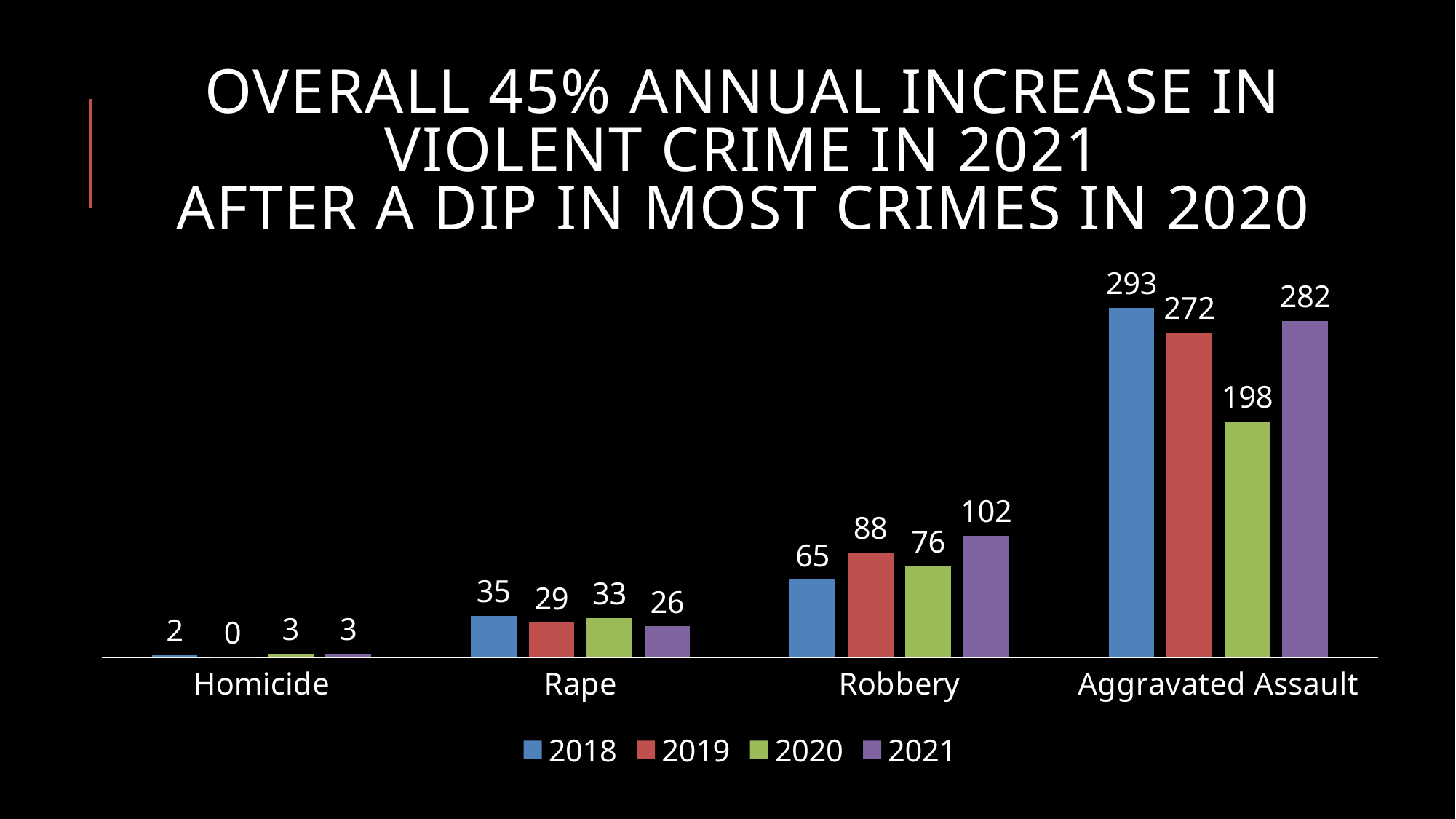
What is the difference between the 2018 and 2020 values for Aggravated Assault? 95 What is the value for Rape in 2018? 35 Which category has the lowest value in 2018? Homicide Which colour represents the 2020 series in the legend? Green How many series does the legend list? 4 How many categories are shown on the x axis? 4 Which category has the highest value in 2021? Aggravated Assault What is the value for Robbery in 2021? 102 What kind of chart is shown on the slide? Bar chart Which is larger for Robbery: the 2019 value or the 2020 value? 2019 What is the value for Homicide in 2019? 0 What is the value for Aggravated Assault in 2020? 198